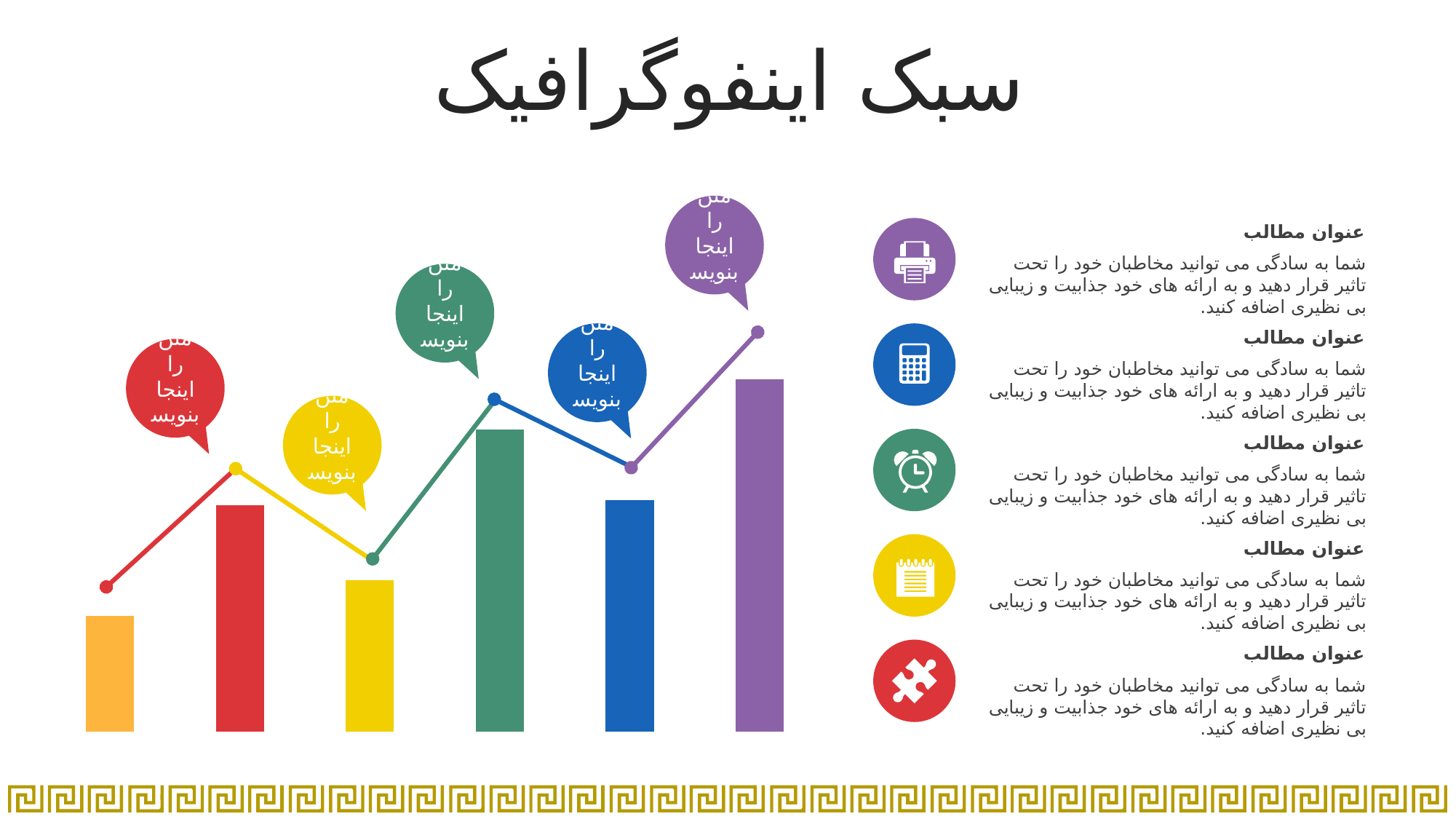
Which is taller in the chart, the red bar or the yellow bar? the red bar Overall, do the bar heights rise or fall from the leftmost bar to the rightmost bar? rise Which bar in the chart is the tallest? the purple bar (rightmost) What kind of chart is shown on the left of the slide? bar chart Which is taller in the chart, the blue bar or the purple bar? the purple bar How many bars does the chart on the left of the slide contain? 6 Which bar in the chart is the shortest? the orange bar (leftmost) Do the bars in the chart rise steadily from left to right without any dips? No What colour is the tallest bar in the chart? purple How many speech-bubble callouts are placed above the chart? 5 Which is taller in the chart, the green bar or the blue bar? the green bar